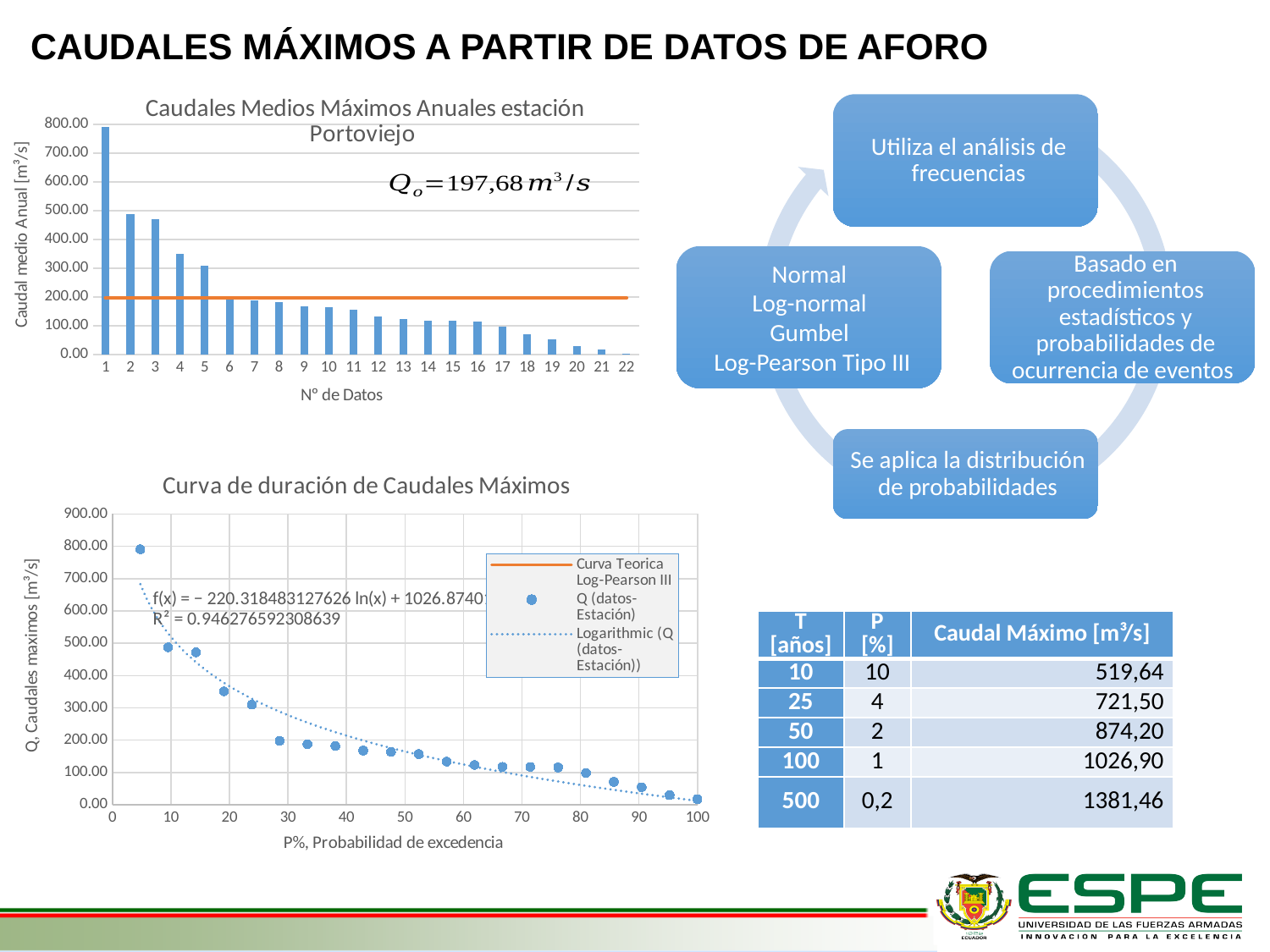
How many series does the legend of the bottom-left chart 'Curva de duración de Caudales Máximos' list? 3 In the top-left bar chart 'Caudales Medios Máximos Anuales estación Portoviejo', what is the x-axis title? N° de Datos In the top-left bar chart 'Caudales Medios Máximos Anuales estación Portoviejo', is the value for data number 1 greater or less than 700.00? greater In the top-left bar chart 'Caudales Medios Máximos Anuales estación Portoviejo', is the value for data number 18 greater or less than 100.00? less In the top-left bar chart 'Caudales Medios Máximos Anuales estación Portoviejo', which data number has the lowest value? 22 In the top-left bar chart 'Caudales Medios Máximos Anuales estación Portoviejo', which data number has the highest value? 1 In the top-left bar chart 'Caudales Medios Máximos Anuales estación Portoviejo', what value of Qo is printed on the chart? 197,68 m³/s In the top-left bar chart 'Caudales Medios Máximos Anuales estación Portoviejo', do the bar values rise or fall as the data number increases along the x axis? fall In the top-left bar chart 'Caudales Medios Máximos Anuales estación Portoviejo', how many data points (bars) are plotted along the x axis? 22 In the bottom-left chart 'Curva de duración de Caudales Máximos', do the Q values rise or fall as P% increases along the x axis? fall In the bottom-left chart 'Curva de duración de Caudales Máximos', what R² value is printed on the chart? 0.946276592308639 What kind of chart is the top-left chart titled 'Caudales Medios Máximos Anuales estación Portoviejo'? bar chart